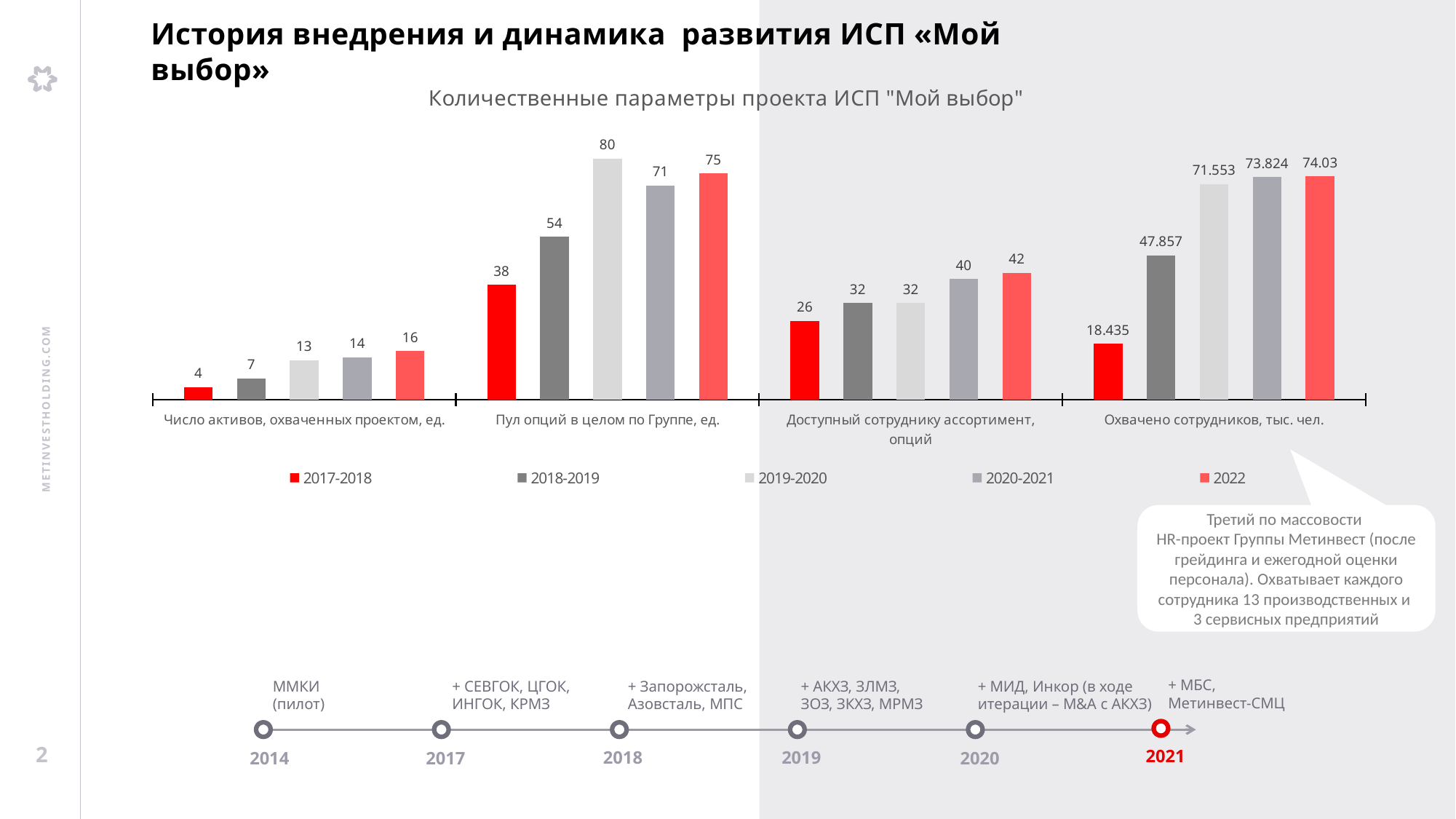
Do the values in the category "Охвачено сотрудников, тыс. чел." rise or fall from 2017-2018 to 2022? rise What is the value for 2022 in the category "Пул опций в целом по Группе, ед."? 75 What type of chart is shown on the slide? bar chart What is the value for 2020-2021 in the category "Доступный сотруднику ассортимент, опций"? 40 What is the title of the chart? Количественные параметры проекта ИСП "Мой выбор" How many categories are shown on the x axis of the chart? 4 What is the difference between the 2022 and 2017-2018 values in the category "Число активов, охваченных проектом, ед."? 12 Which series has the lowest value in the category "Число активов, охваченных проектом, ед."? 2017-2018 Which series has the highest value in the category "Пул опций в целом по Группе, ед."? 2019-2020 How many series does the legend list? 5 What is the value for 2017-2018 in the category "Охвачено сотрудников, тыс. чел."? 18.435 Which is larger in the category "Пул опций в целом по Группе, ед.": the 2018-2019 value or the 2020-2021 value? 2020-2021